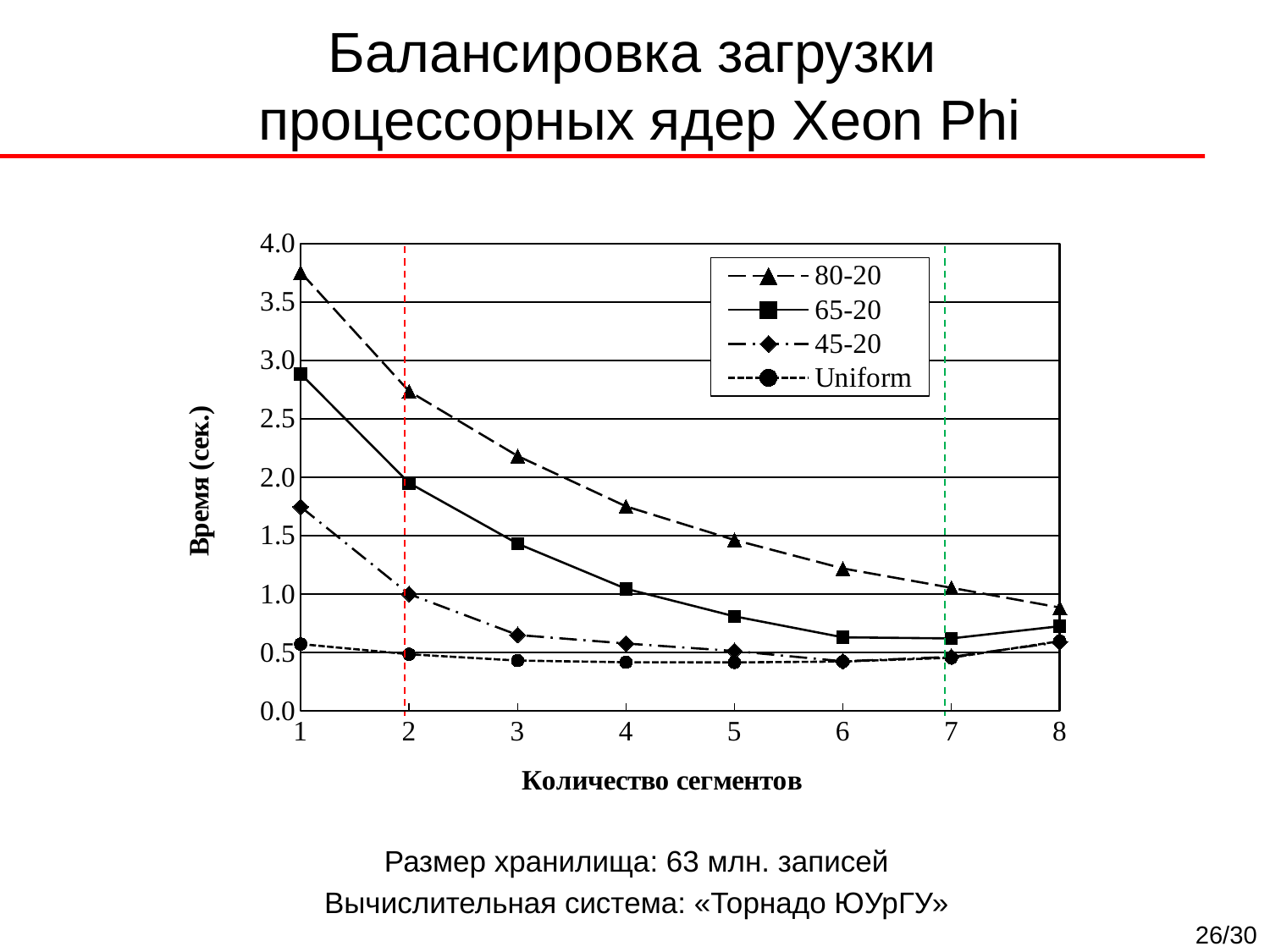
Is the value for the Uniform series at 4 segments greater or less than 1.0? less Is the value for the 45-20 series at 1 segment greater or less than 1.5? greater Does the 80-20 series rise or fall as the number of segments increases from 1 to 8? fall How many series does the legend list? 4 How many segment counts (x-axis points) are plotted for each series? 8 Which series has the highest value at 1 segment? 80-20 What kind of chart is shown on the slide? line chart At 3 segments, which series has the larger value: 80-20 or 65-20? 80-20 Is the value for the 65-20 series at 5 segments greater or less than 1.0? less Which series has the lowest value at 1 segment? Uniform